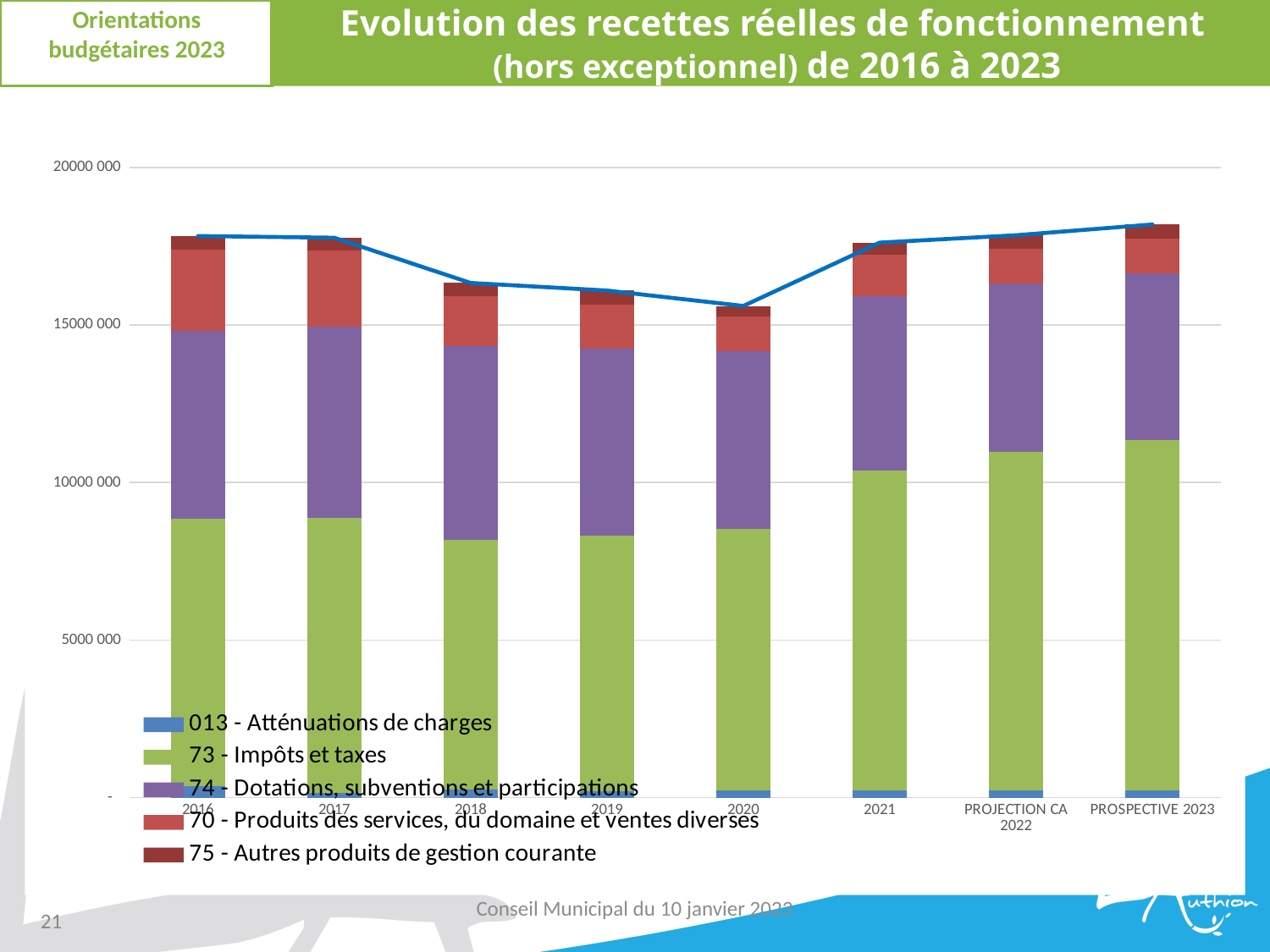
Is the total stacked bar for 2018 greater or less than 20000 000? less Is the '73 - Impôts et taxes' segment for 2016 greater or less than 10000 000? less Which has the larger total stacked bar, 2019 or 2021? 2021 How many categories (years/periods) are shown on the x axis? 8 How many series does the legend list? 5 Which category has the lowest total stacked bar? 2020 Which series is shown in green in the legend? 73 - Impôts et taxes What is the title of the chart? Evolution des recettes réelles de fonctionnement (hors exceptionnel) de 2016 à 2023 Is the total stacked bar for 2016 greater or less than 15000 000? greater Do the total stacked bars rise or fall from 2020 to PROSPECTIVE 2023? rise What kind of chart is shown on the slide? Stacked bar chart with a line